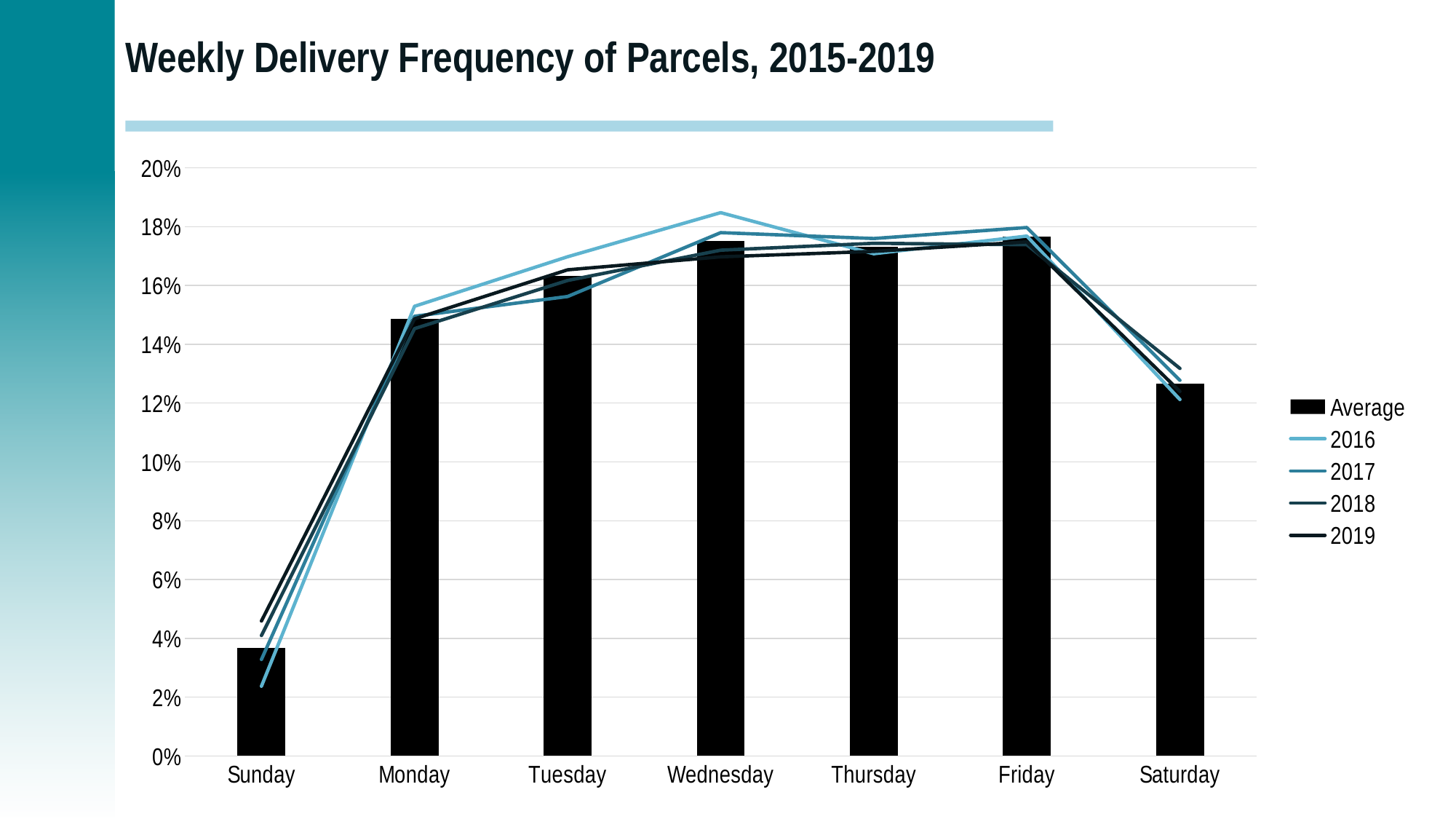
What is the title of the chart? Weekly Delivery Frequency of Parcels, 2015-2019 Which series is shown as bars rather than lines? Average Is the Average value for Monday greater or less than 14%? greater Is the Average value for Saturday greater or less than 12%? greater Does the Average value rise or fall from Sunday to Wednesday? rise Is the Average value for Sunday greater or less than 6%? less What kind of chart is shown on the slide? A combined bar and line chart How many days of the week are shown on the x axis? 7 Which day has the lowest Average bar? Sunday How many series does the legend list? 5 Which has the larger Average value, Monday or Tuesday? Tuesday